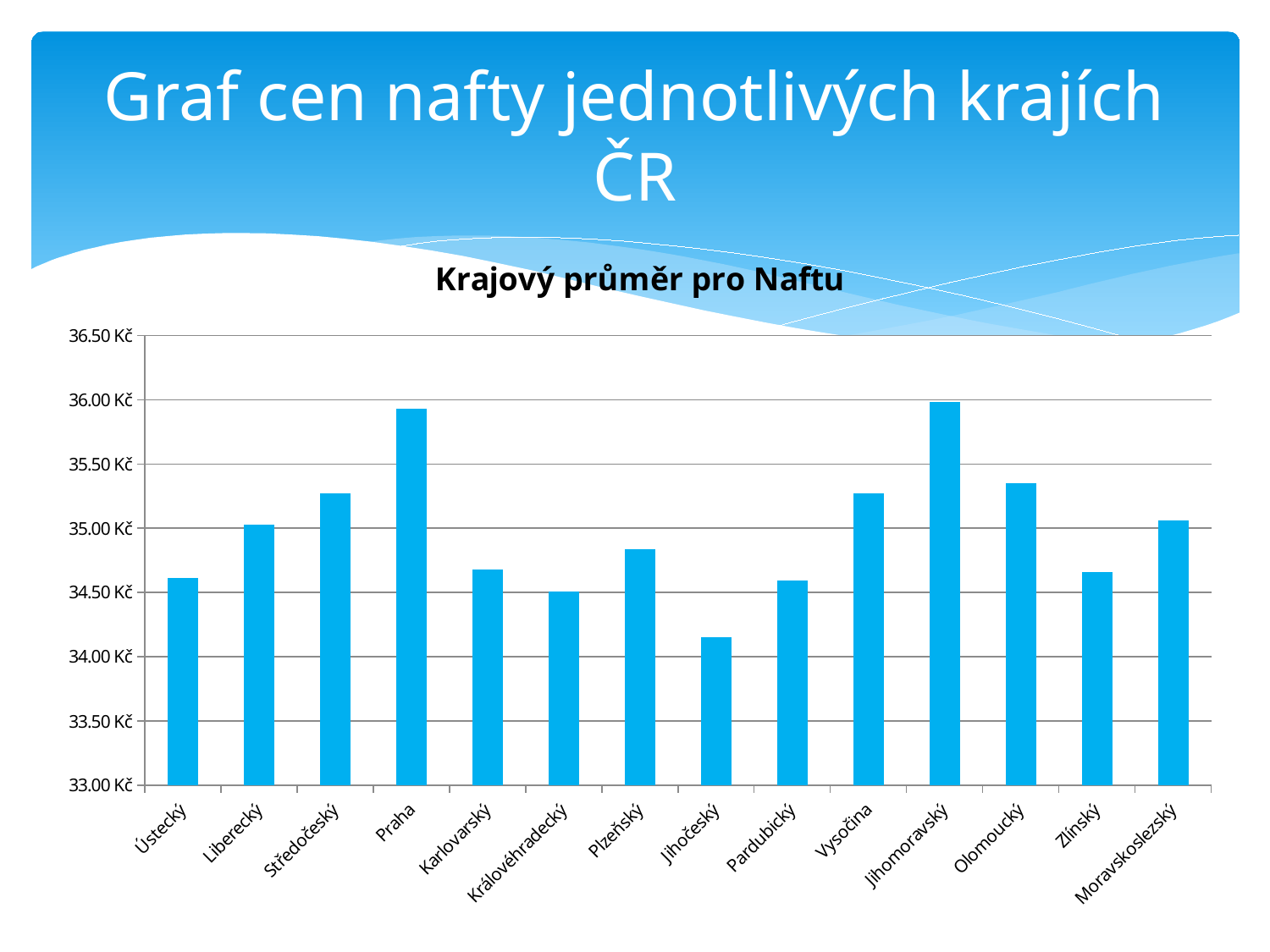
Which region has the lowest value in the chart? Jihočeský How many regions (categories) are shown on the x axis of the chart? 14 Which has the larger value, Olomoucký or Zlínský? Olomoucký Is the value for Olomoucký greater or less than 35.00 Kč? greater What is the title of the chart? Krajový průměr pro Naftu Which region has the highest value in the chart? Jihomoravský Which has the larger value, Praha or Jihočeský? Praha Is the value for Praha greater or less than 35.50 Kč? greater Is the value for Plzeňský greater or less than 35.00 Kč? less What kind of chart is shown on the slide? Bar chart